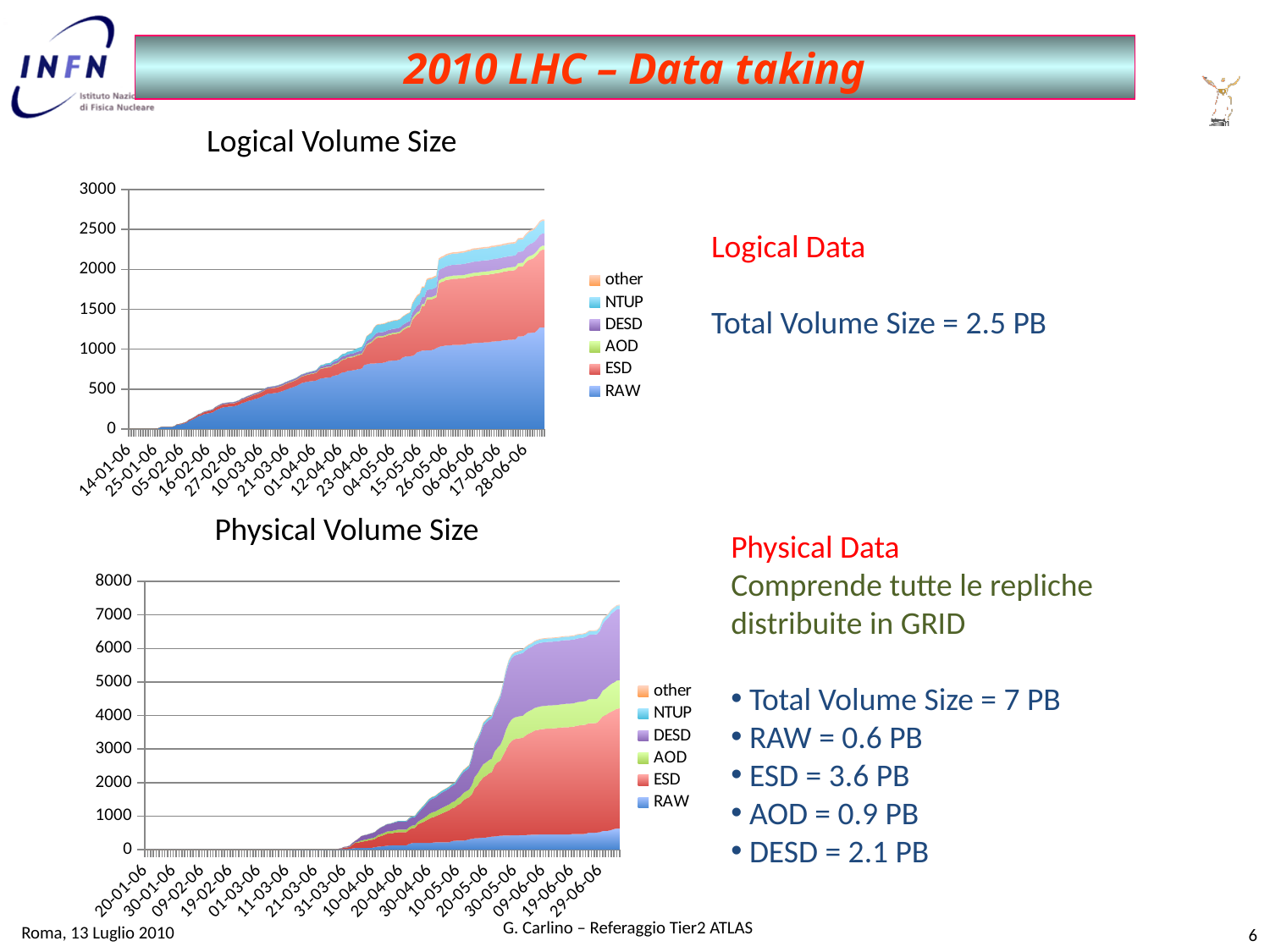
How many series does the legend of the Logical Volume Size chart list? 6 What is the title of the lower chart on the slide? Physical Volume Size In the Logical Volume Size chart, do the stacked values rise or fall along the x axis from 14-01-06 to 28-06-06? rise In the Physical Volume Size chart, is the total stacked value at the end of the period greater or less than 6000? greater In the Physical Volume Size chart, is the total stacked value on 31-03-06 greater or less than 1000? less In the Logical Volume Size chart, is the total stacked value at the end of the period greater or less than 2000? greater In the Physical Volume Size chart, do the stacked values rise or fall over time along the x axis? rise Which series is listed at the bottom of the legend in the Logical Volume Size chart? RAW What kind of chart is the Logical Volume Size chart? stacked area chart How many series does the legend of the Physical Volume Size chart list? 6